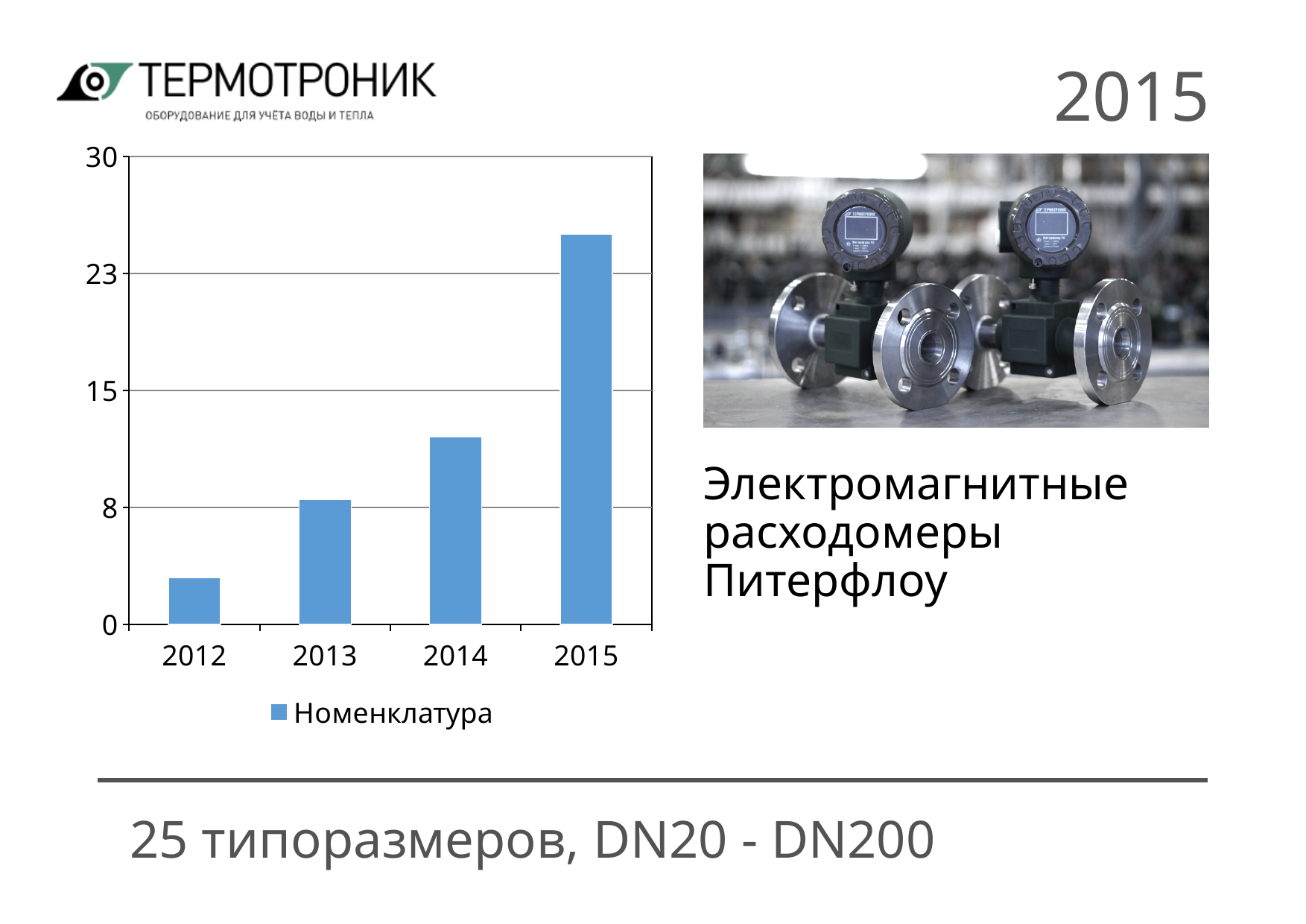
How many series does the chart legend list? 1 Do the values rise or fall from 2012 to 2015? rise Which year has the larger value, 2013 or 2014? 2014 Is the value for 2015 greater or less than 23? greater How many years are shown on the x axis of the chart? 4 What is the name of the series shown in the chart legend? Номенклатура Which year has the highest value in the chart? 2015 Which year has the lowest value in the chart? 2012 Is the value for 2012 greater or less than 8? less What kind of chart is shown on the slide? bar chart Is the value for 2014 greater or less than 8? greater